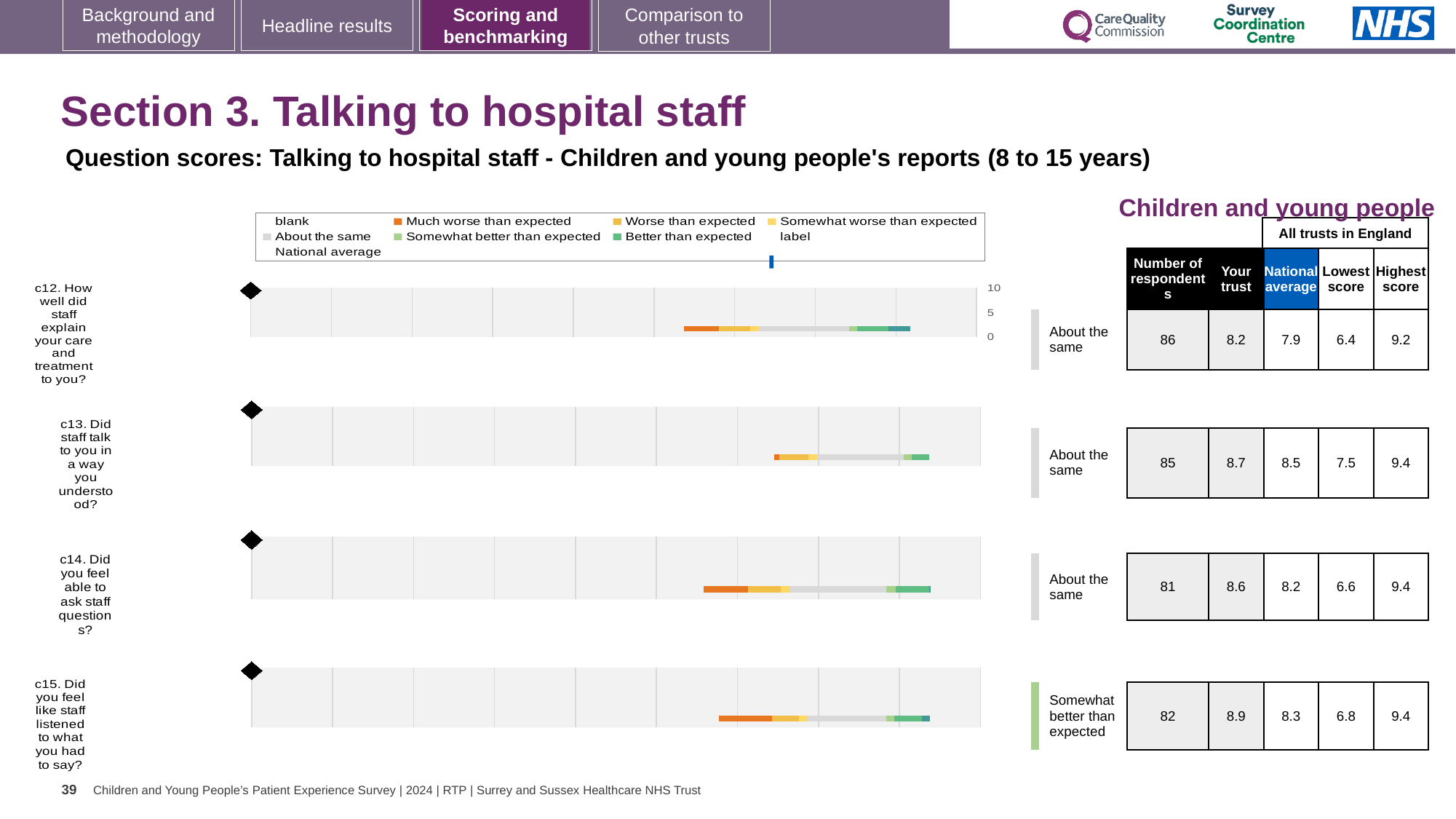
What is the national average score for c12 (How well did staff explain your care and treatment to you?)? 7.9 How many respondents answered c14 (Did you feel able to ask staff questions?)? 81 What is the lowest score among all trusts in England for c12? 6.4 For c14, which is larger: the 'Your trust' score or the national average? Your trust Which question has the lowest 'Your trust' score? c12 What kind of chart is used to show the question scores for c12 to c15? Bar chart What is the 'Your trust' score for c15 (Did you feel like staff listened to what you had to say?)? 8.9 What benchmark category is shown for c15? Somewhat better than expected Which question has the highest 'Your trust' score? c15 How many questions (c12 to c15) are plotted on the slide? 4 What colour does the legend use for 'Much worse than expected'? Orange For c13, what is the difference between the 'Your trust' score and the national average? 0.2